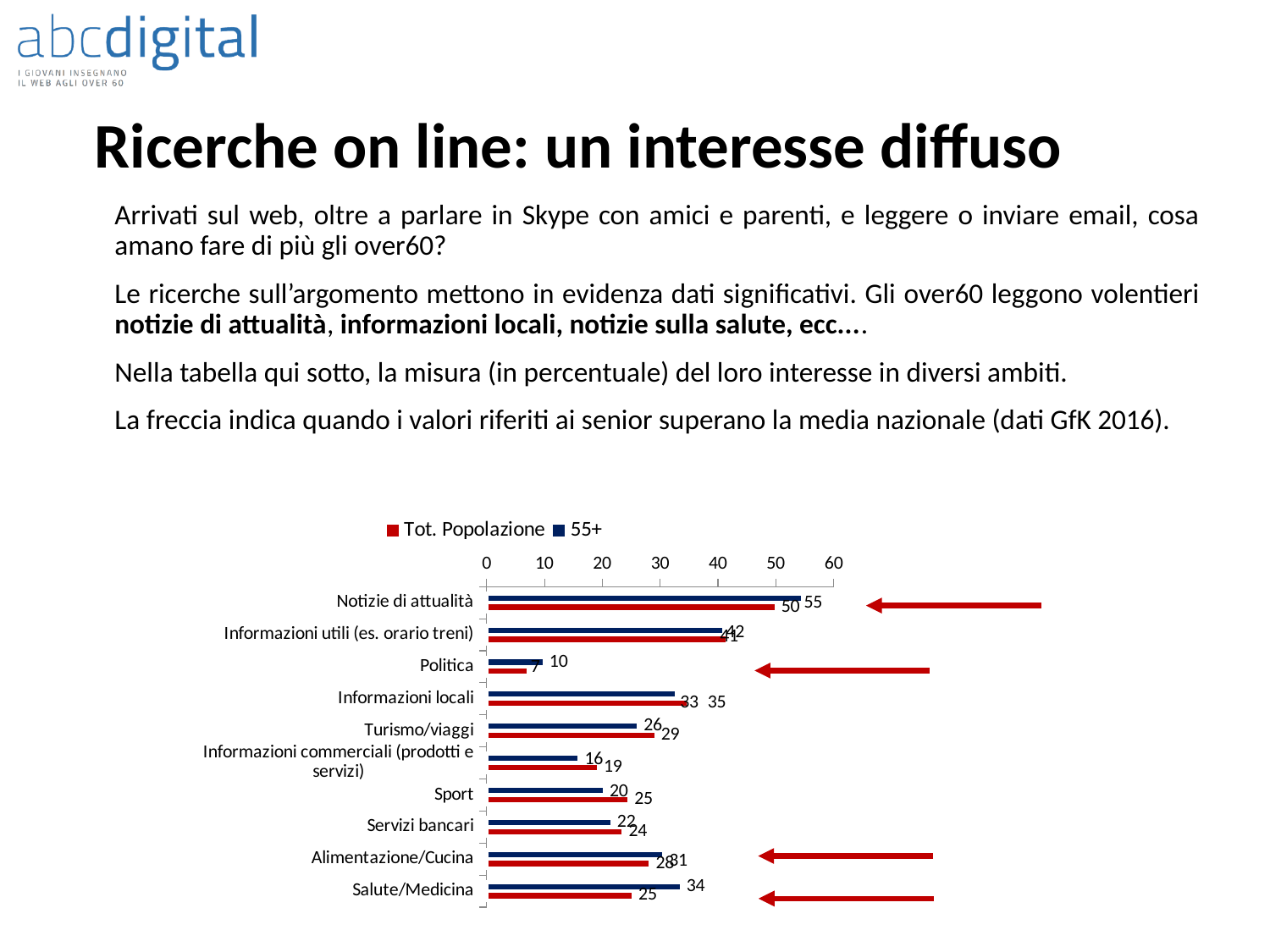
Which category has the highest value for the 55+ series? Notizie di attualità What is the Tot. Popolazione value for Turismo/viaggi? 29 Which category has the lowest value for the Tot. Popolazione series? Politica How many series does the legend list? 2 What is the value for the 55+ series for Notizie di attualità? 55 What kind of chart is shown on the slide? bar chart What is the Tot. Popolazione value for Politica? 7 Is the 55+ value for Informazioni utili (es. orario treni) greater or less than 40? greater For Sport, which series has the larger value, 55+ or Tot. Popolazione? Tot. Popolazione How many categories are shown in the chart? 10 What is the 55+ value for Salute/Medicina? 34 For Salute/Medicina, what is the difference between the 55+ value and the Tot. Popolazione value? 9